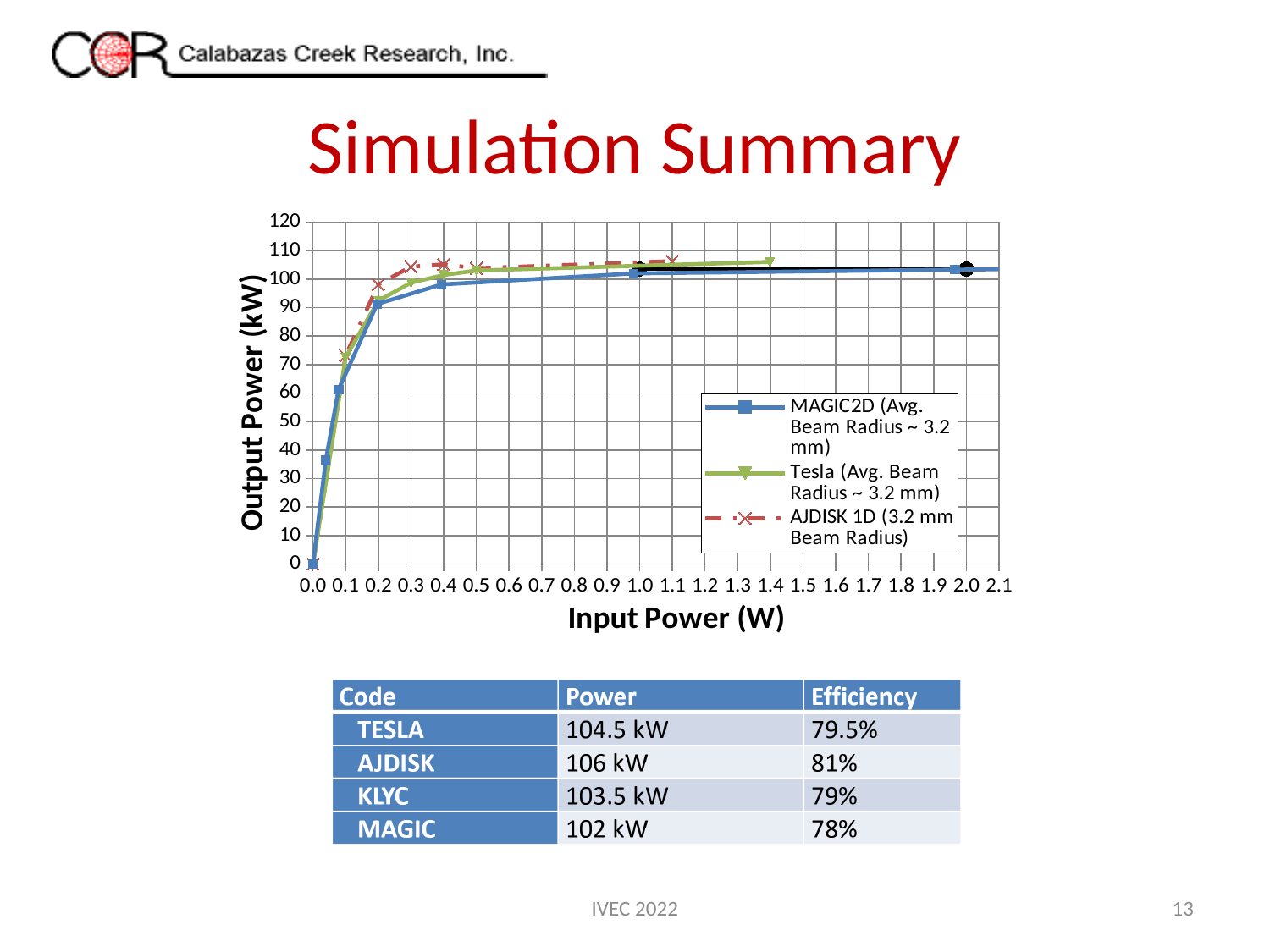
What is the title of the chart's x axis? Input Power (W) Is the MAGIC2D output power at 0.1 W input greater or less than 50 kW? greater Is the MAGIC2D output power at 0.1 W input greater or less than 70 kW? less How many series does the chart legend list? 3 What is the title of the chart's y axis? Output Power (kW) Does the MAGIC2D output power rise or fall as input power increases from 0.0 to 0.4 W? rise Is the MAGIC2D output power at 0.2 W input greater or less than 80 kW? greater What kind of chart is shown on the slide? line chart At 0.1 W input power, which series has the higher output power, Tesla or MAGIC2D? Tesla At 0.4 W input power, which series has the higher output power, AJDISK 1D or MAGIC2D? AJDISK 1D